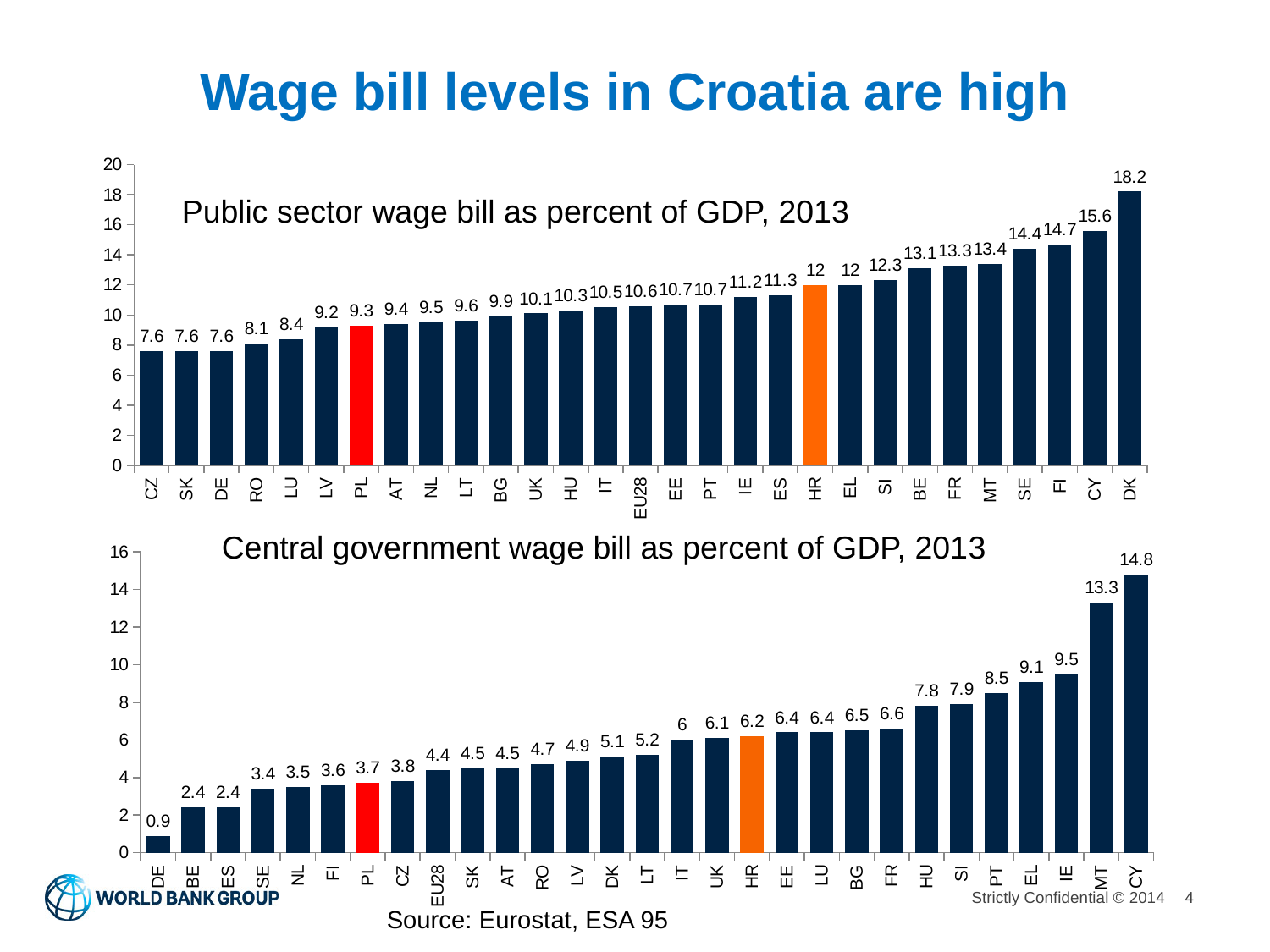
In the 'Public sector wage bill as percent of GDP, 2013' chart, what is the difference between the values for DK and CY? 2.6 In the 'Central government wage bill as percent of GDP, 2013' chart, do the values rise or fall from left to right? rise In the 'Public sector wage bill as percent of GDP, 2013' chart, what is the value for EU28? 10.6 In the 'Public sector wage bill as percent of GDP, 2013' chart, what is the value for HR? 12 In the 'Public sector wage bill as percent of GDP, 2013' chart, how many countries/categories are shown? 29 In the 'Public sector wage bill as percent of GDP, 2013' chart, which country has the highest value? DK In the 'Central government wage bill as percent of GDP, 2013' chart, what is the value for HR? 6.2 What type of chart is the 'Central government wage bill as percent of GDP, 2013' chart? bar chart In the 'Central government wage bill as percent of GDP, 2013' chart, which country has the lowest value? DE In the 'Central government wage bill as percent of GDP, 2013' chart, what is the difference between the values for HR and PL? 2.5 In the 'Central government wage bill as percent of GDP, 2013' chart, what is the value for CY? 14.8 In the 'Public sector wage bill as percent of GDP, 2013' chart, which is larger, the value for PL or the value for HR? HR